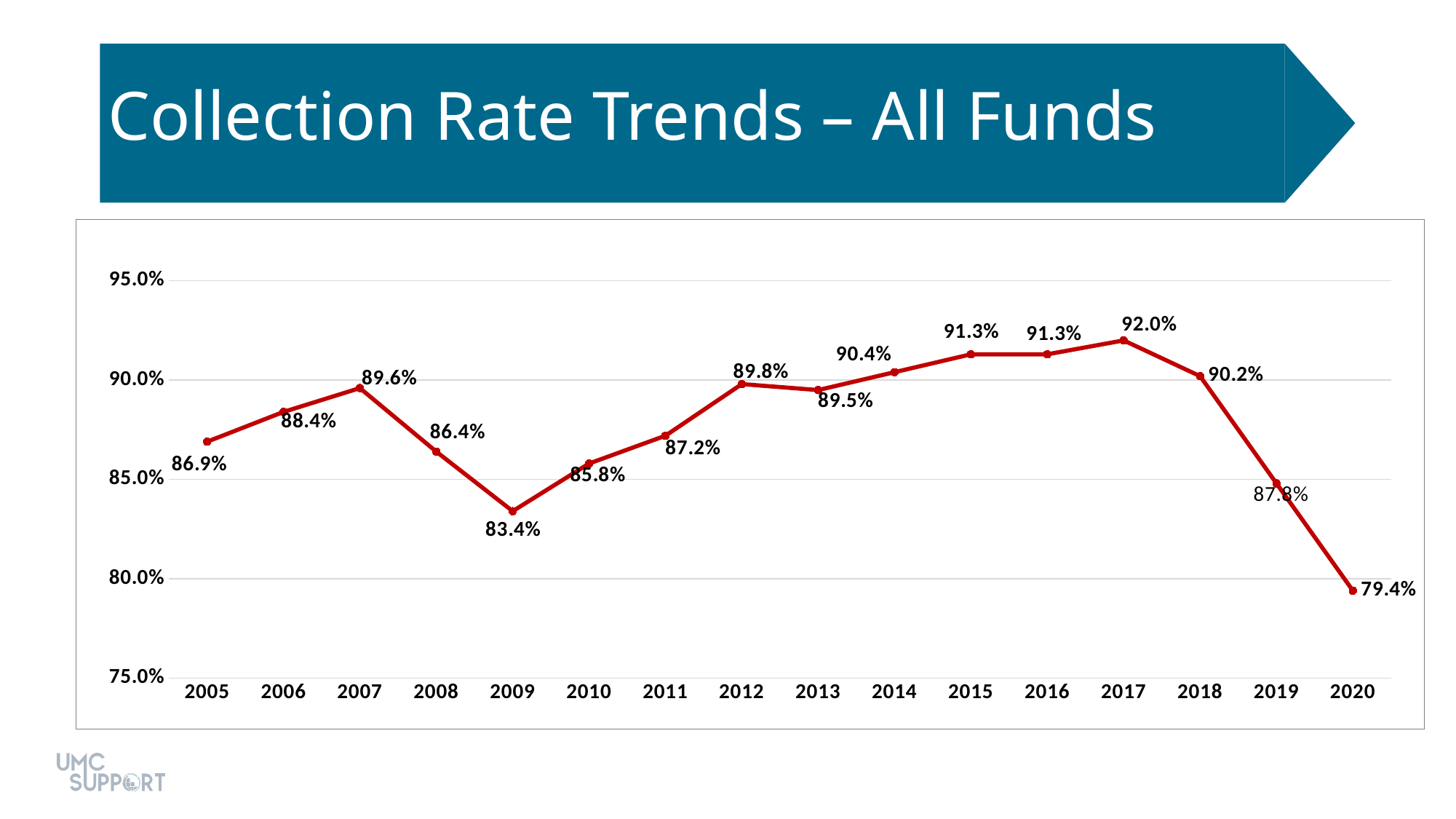
Which year has the lowest collection rate? 2020 What is the collection rate for 2017? 92.0% Is the value for 2009 greater or less than 85.0%? less How many years are plotted on the chart? 16 What is the collection rate for 2009? 83.4% Do the values rise or fall from 2017 to 2020? fall Which year has the highest collection rate? 2017 What is the collection rate for 2020? 79.4% What is the collection rate for 2012? 89.8% Which year has a higher collection rate, 2007 or 2008? 2007 What kind of chart is shown on the slide? line chart What is the difference between the collection rates for 2017 and 2020? 12.6%